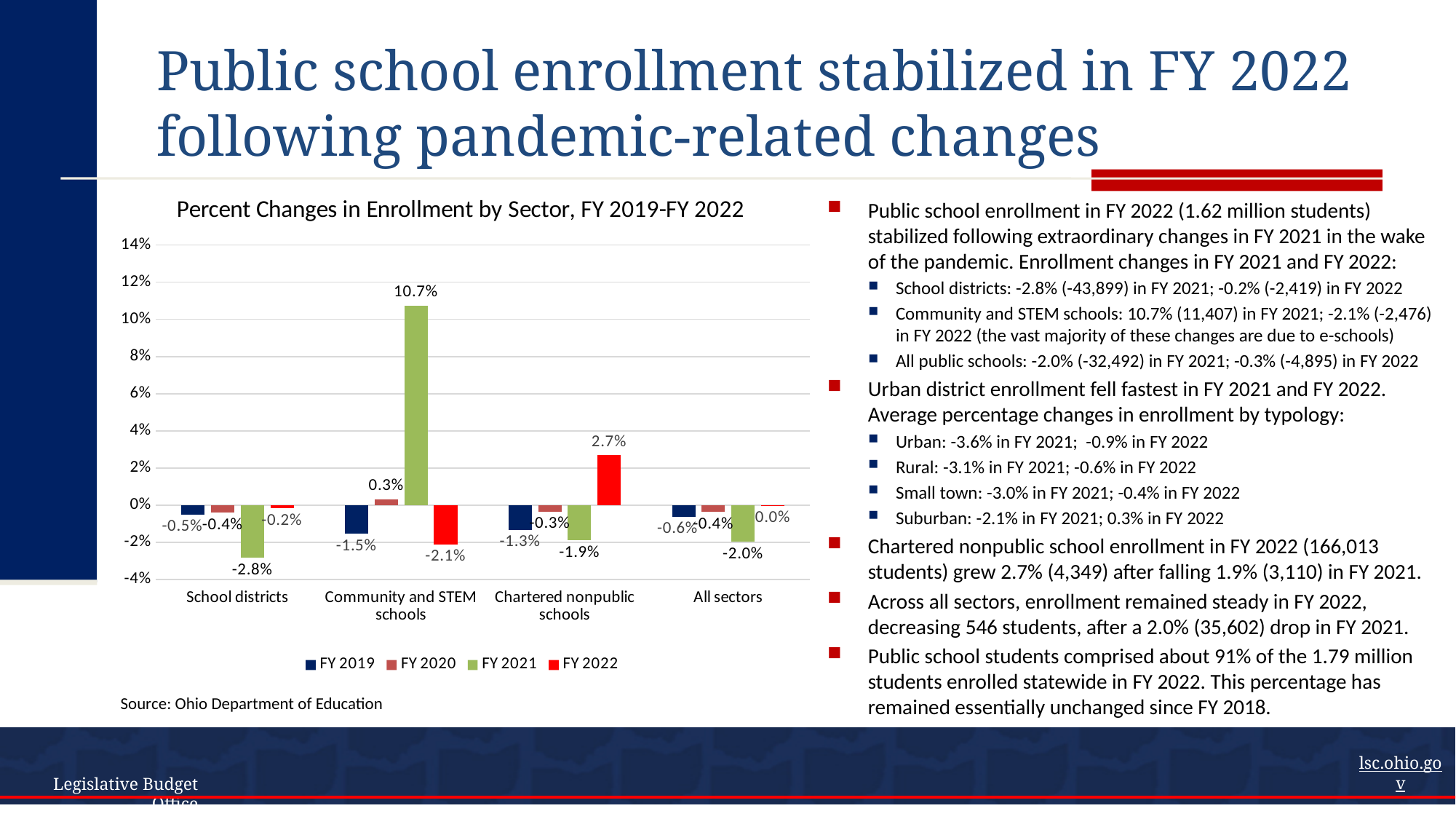
How many series does the legend list? 4 Which sector has the lowest FY 2022 percent change in enrollment? Community and STEM schools What is the FY 2021 percent change in enrollment for Community and STEM schools? 10.7% What is the difference in percentage points between the FY 2021 and FY 2022 values for Community and STEM schools? 12.8 percentage points Which is larger, the FY 2019 value for School districts or the FY 2019 value for Chartered nonpublic schools? School districts What is the FY 2022 percent change in enrollment for All sectors? 0.0% Is the FY 2021 value for Community and STEM schools greater or less than 8%? greater What is the FY 2021 percent change in enrollment for School districts? -2.8% What is the FY 2022 percent change in enrollment for Chartered nonpublic schools? 2.7% Which sector has the highest FY 2021 percent change in enrollment? Community and STEM schools How many sector categories are shown on the x axis? 4 What is the title of the chart? Percent Changes in Enrollment by Sector, FY 2019-FY 2022